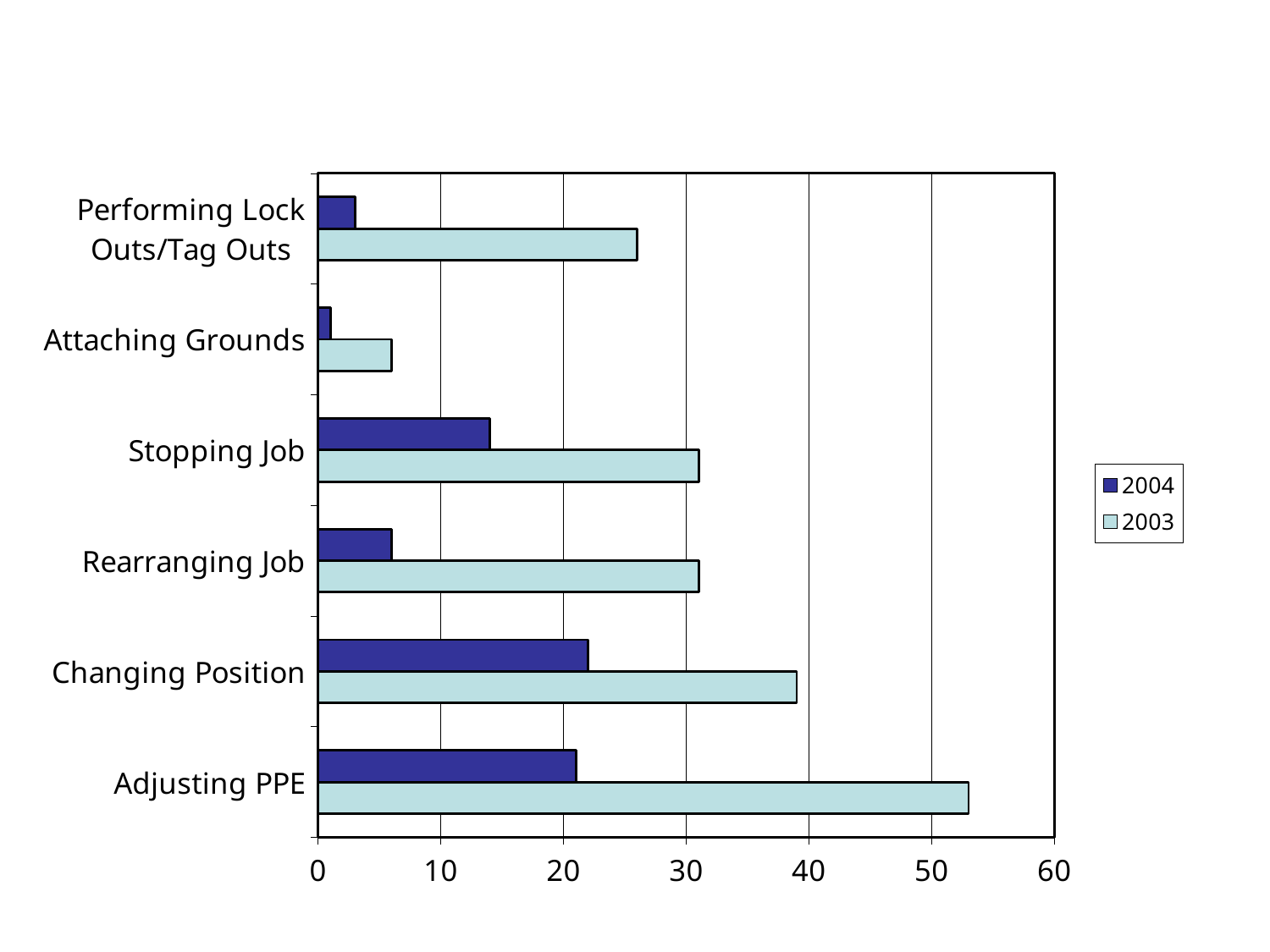
Is the 2003 value for Adjusting PPE greater or less than 50? greater For 2003, which is larger, Changing Position or Stopping Job? Changing Position Which category has the highest value for 2003? Adjusting PPE How many categories are shown on the chart? 6 Is the 2003 value for Attaching Grounds greater or less than 10? less For Adjusting PPE, which series has the larger value, 2003 or 2004? 2003 Is the 2003 value for Performing Lock Outs/Tag Outs greater or less than 20? greater What kind of chart is shown on the slide? bar chart Which category has the lowest value for 2003? Attaching Grounds Which series is shown in dark blue in the legend? 2004 How many series does the legend list? 2